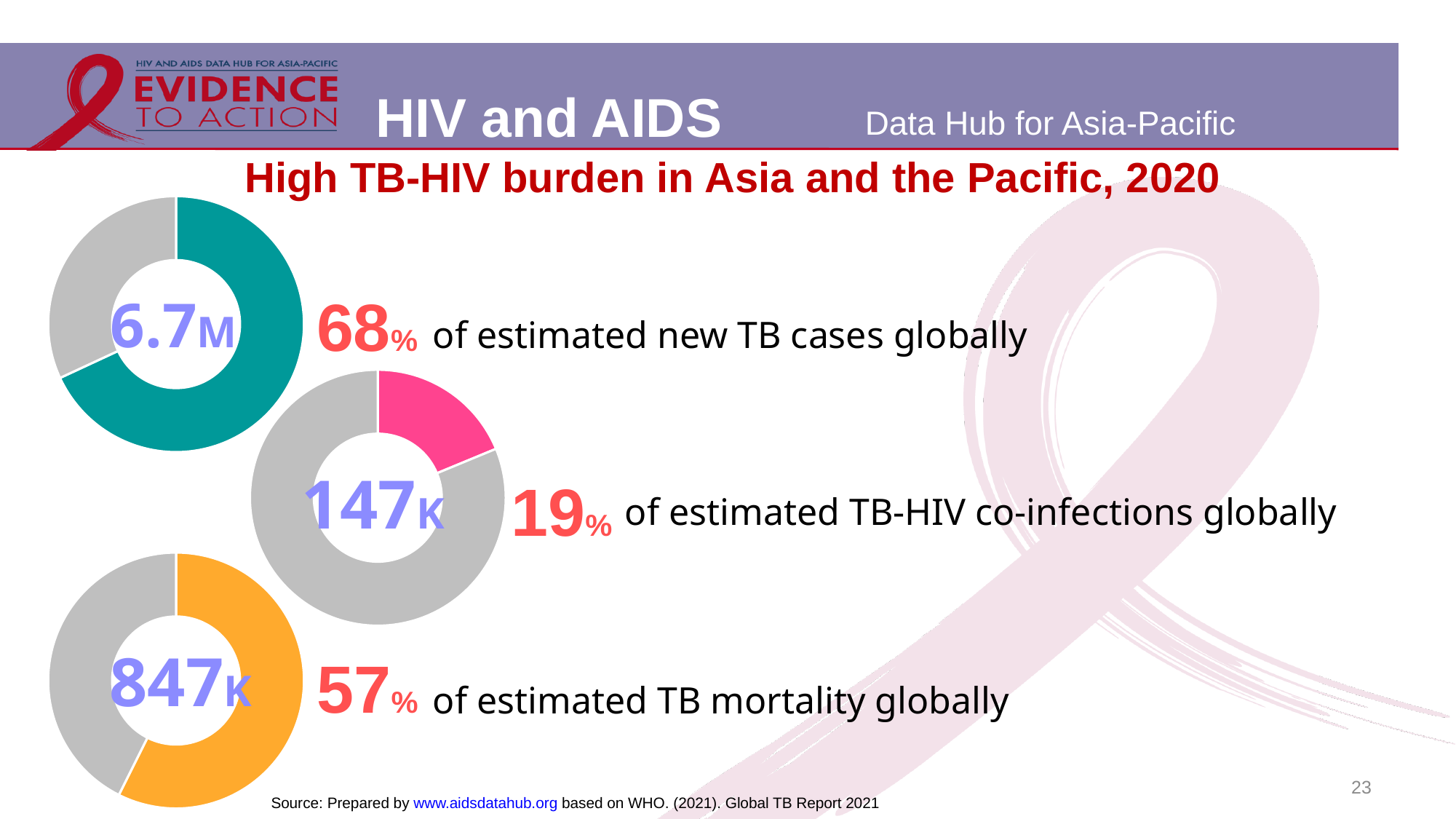
What kind of chart is used to show the share of estimated new TB cases globally? Donut (pie) chart Is the share of estimated TB mortality globally (57%) larger or smaller than the share of estimated TB-HIV co-infections globally (19%)? Larger In the middle donut chart, what number is printed in the centre for estimated TB-HIV co-infections in Asia and the Pacific? 147K Which of the three donut charts shows the highest percentage share for Asia and the Pacific? Estimated new TB cases globally (68%) In the bottom donut chart, what number is printed in the centre for estimated TB mortality in Asia and the Pacific? 847K In the bottom donut chart, what share of estimated TB mortality globally does Asia and the Pacific account for? 57% In the top donut chart, what share of estimated new TB cases globally does Asia and the Pacific account for? 68% Which of the three donut charts shows the lowest percentage share for Asia and the Pacific? Estimated TB-HIV co-infections globally (19%) How many donut charts are shown on the slide? 3 In the middle donut chart, what share of estimated TB-HIV co-infections globally does Asia and the Pacific account for? 19% What is the difference in percentage points between the share of estimated new TB cases (68%) and the share of estimated TB mortality (57%)? 11 percentage points In the top donut chart, what number is printed in the centre for estimated new TB cases in Asia and the Pacific? 6.7M